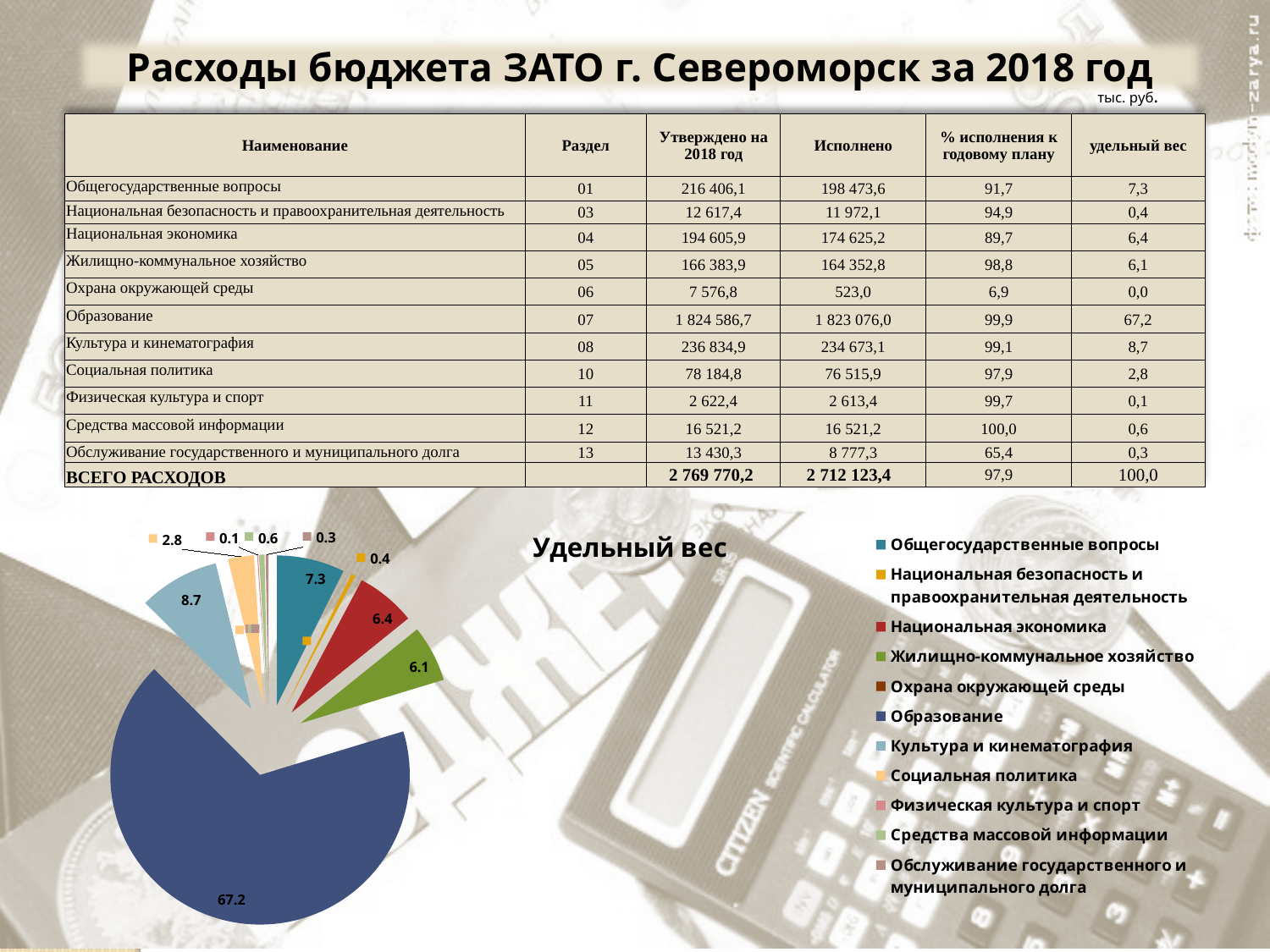
In the pie chart, what is the value shown for Образование? 67.2 How many entries does the chart's legend list? 11 In the pie chart, which is larger: Национальная экономика or Жилищно-коммунальное хозяйство? Национальная экономика Which category has the largest slice in the pie chart? Образование In the pie chart, what is the value shown for Общегосударственные вопросы? 7.3 In the pie chart, what is the value shown for Социальная политика? 2.8 In the pie chart, what is the value shown for Культура и кинематография? 8.7 In the pie chart, which is larger: Социальная политика or Национальная безопасность и правоохранительная деятельность? Социальная политика What is the title of the chart on the slide? Удельный вес In the pie chart, what is the difference between the values for Культура и кинематография and Общегосударственные вопросы? 1.4 In the pie chart, what is the value shown for Жилищно-коммунальное хозяйство? 6.1 What kind of chart is shown on the slide? pie chart